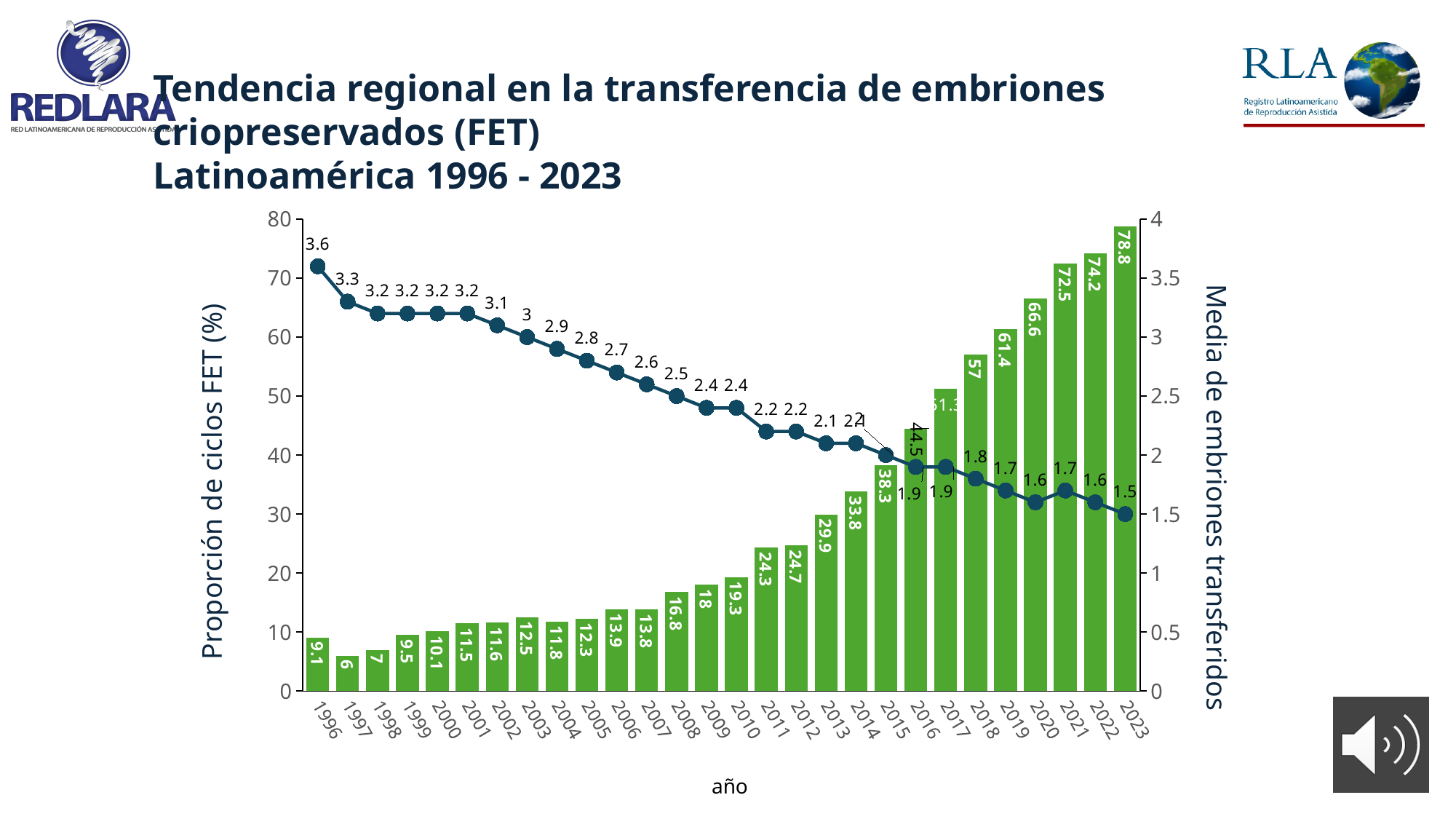
Which year has the lowest bar for proportion of FET cycles? 1997 What is the mean number of embryos transferred shown by the line for 1996? 3.6 Which is larger, the bar value for 2006 or for 2007? 2006 Is the bar value for 2018 greater or less than 50? greater What is the proportion of FET cycles (%) shown by the bar for 2023? 78.8 Does the line for mean embryos transferred rise or fall from 1996 to 2023? Fall What kind of chart is this? Combined bar and line chart Which year has the highest bar for proportion of FET cycles? 2023 What is the label of the x axis? año What is the difference between the bar values for 2023 and 2022? 4.6 How many years are shown on the x axis? 28 What is the proportion of FET cycles (%) shown by the bar for 2010? 19.3